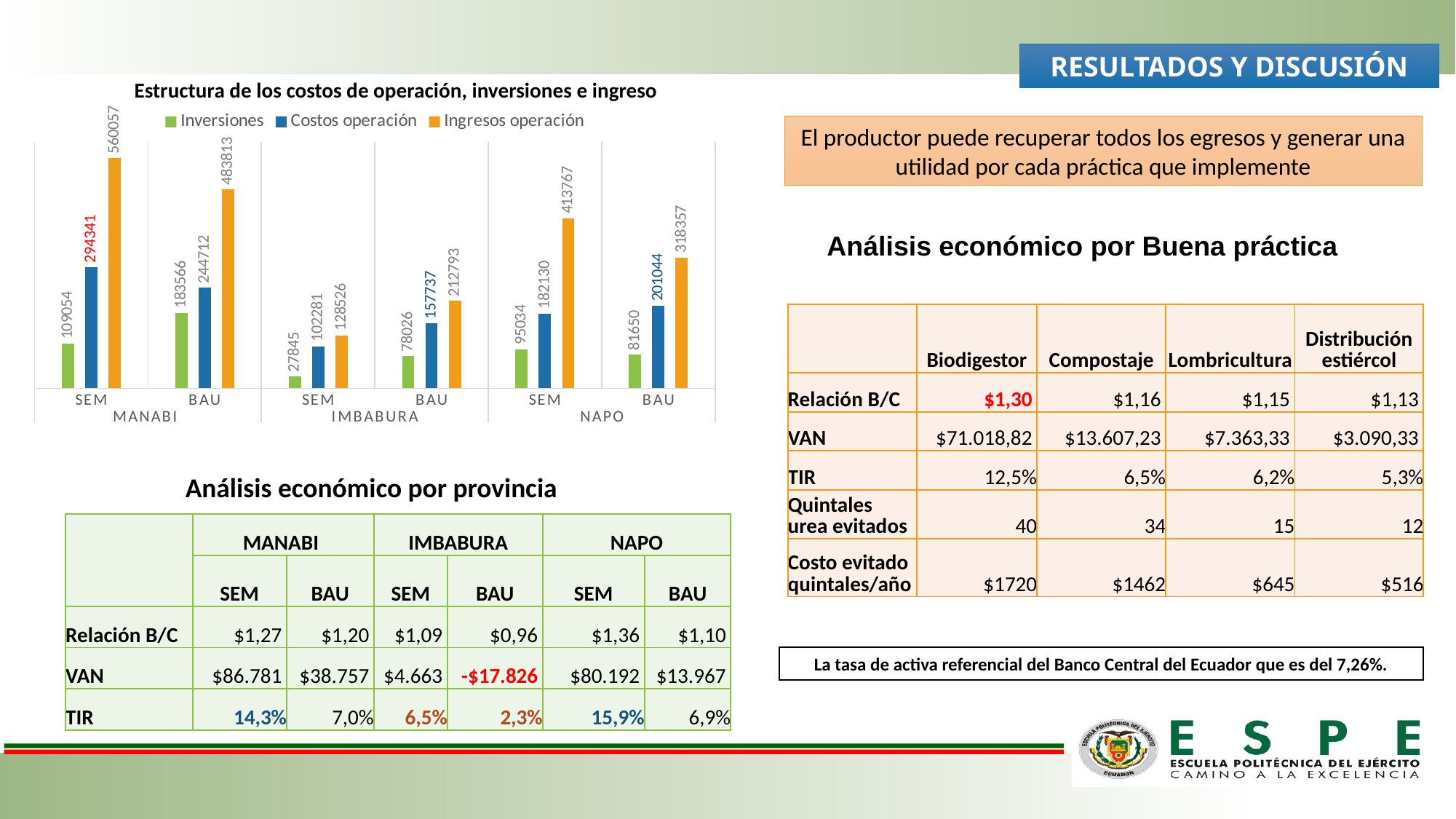
Which is larger: Costos operación for SEM in NAPO or Costos operación for BAU in NAPO? BAU in NAPO What is the title of the chart? Estructura de los costos de operación, inversiones e ingreso Which category has the highest Ingresos operación value? SEM in MANABI What is the value of Inversiones for BAU in IMBABURA? 78026 What is the value of Costos operación for BAU in NAPO? 201044 How many categories (SEM/BAU groups) are plotted on the x axis? 6 What kind of chart is shown on the slide? Bar chart What is the value of Ingresos operación for SEM in MANABI? 560057 Which category has the lowest Inversiones value? SEM in IMBABURA What is the difference between Ingresos operación and Inversiones for SEM in IMBABURA? 100681 What is the difference between Ingresos operación and Costos operación for SEM in MANABI? 265716 How many series does the chart legend list? 3